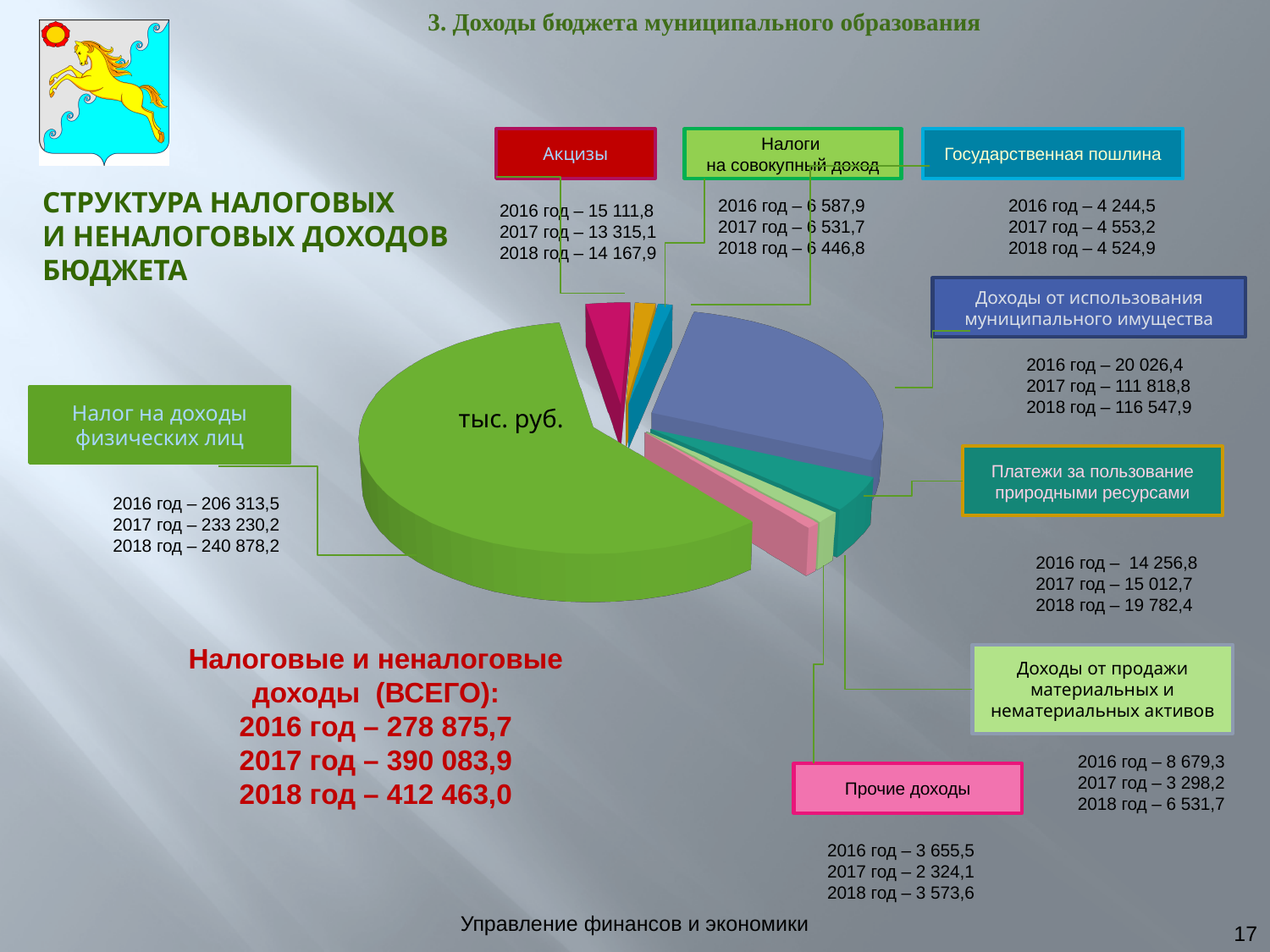
What is the difference between the 2018 and 2017 values for Доходы от использования муниципального имущества? 4 729,1 What kind of chart is shown on the slide? pie chart Which is larger in 2018: Платежи за пользование природными ресурсами or Акцизы? Платежи за пользование природными ресурсами How many categories (slices) does the pie chart have? 8 Which category is the largest slice of the pie chart? Налог на доходы физических лиц What unit is written in the centre of the pie chart? тыс. руб. What is the value for Акцизы in 2016? 15 111,8 Do the values for Налог на доходы физических лиц rise or fall from 2016 to 2018? rise What is the value for Доходы от продажи материальных и нематериальных активов in 2016? 8 679,3 What is the value for Прочие доходы in 2017? 2 324,1 What is the value for Государственная пошлина in 2017? 4 553,2 What is the value for Налог на доходы физических лиц in 2018? 240 878,2